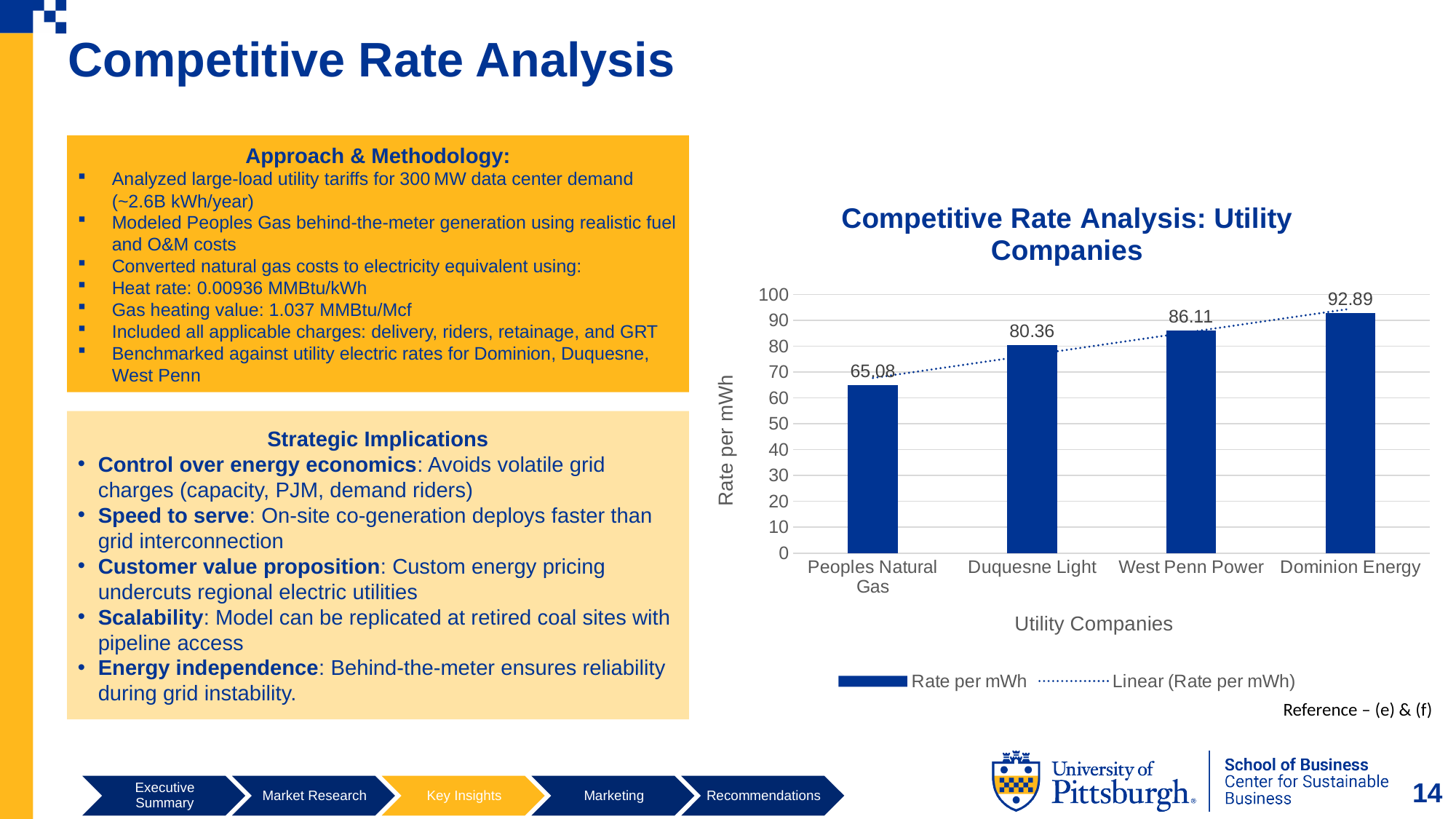
Which is larger, the value for Duquesne Light or the value for West Penn Power? West Penn Power What is the difference between the values for Dominion Energy and Peoples Natural Gas? 27.81 What is the value for Dominion Energy? 92.89 What is the difference between the values for Duquesne Light and Peoples Natural Gas? 15.28 How many utility companies are shown on the chart? 4 Do the values rise or fall from left to right along the x axis? rise What kind of chart is shown on the slide? bar chart What is the value for West Penn Power? 86.11 Which utility company has the highest rate per mWh? Dominion Energy What is the value for Peoples Natural Gas? 65.08 Is the value for Duquesne Light greater or less than 90? less Which utility company has the lowest rate per mWh? Peoples Natural Gas